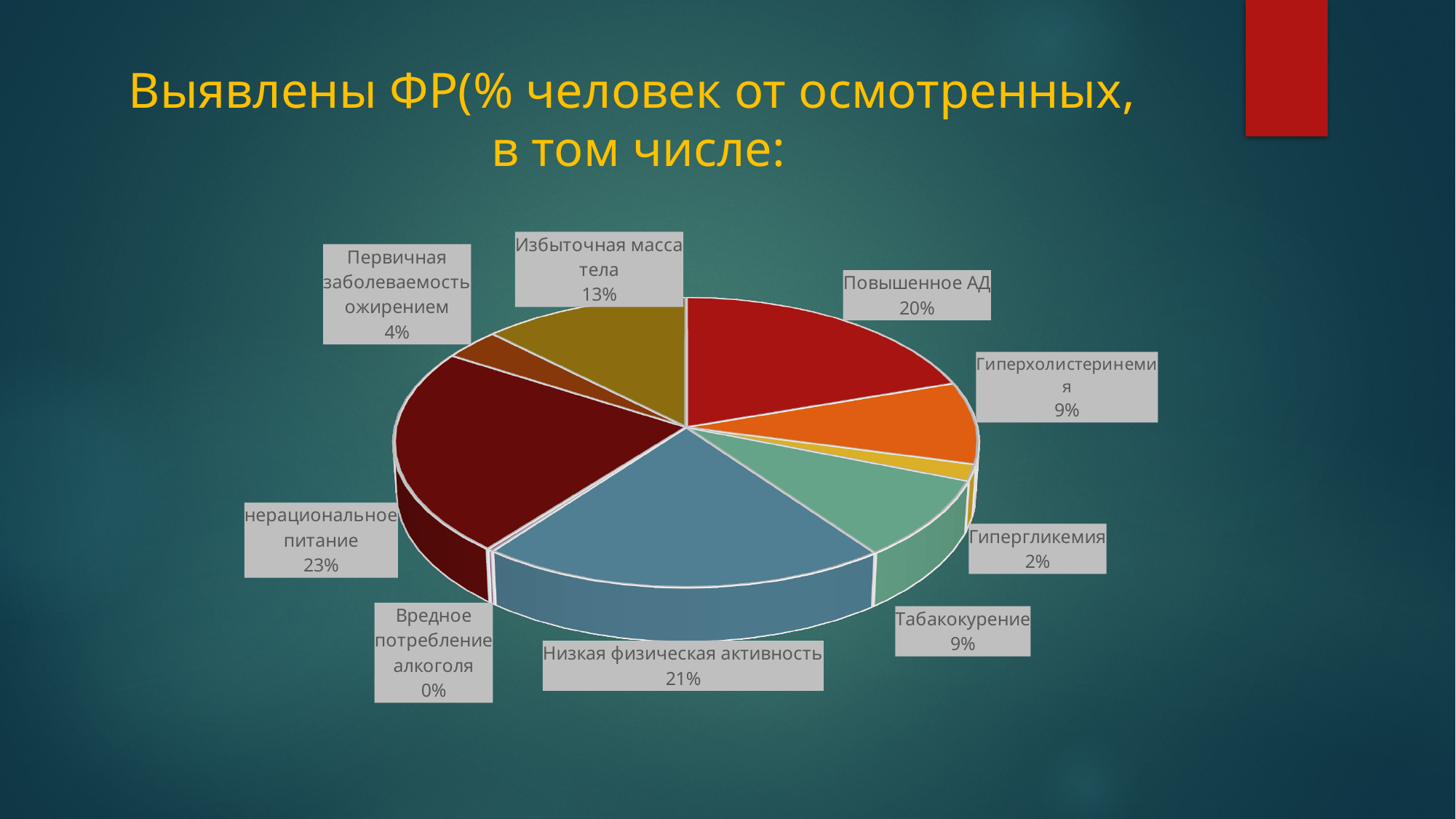
What kind of chart is shown on the slide? pie chart Which category has the smallest share of the pie? Вредное потребление алкоголя What is the difference in percentage points between нерациональное питание and Низкая физическая активность? 2 What is the title of the slide containing the chart? Выявлены ФР(% человек от осмотренных, в том числе: What percentage is shown for Первичная заболеваемость ожирением? 4% What percentage is shown for Низкая физическая активность? 21% Which is larger: the share for Повышенное АД or the share for Избыточная масса тела? Повышенное АД What percentage is shown for Избыточная масса тела? 13% What percentage is shown for Повышенное АД? 20% How many categories are shown in the pie chart? 9 What percentage is shown for Гипергликемия? 2% Which category has the largest share of the pie? нерациональное питание